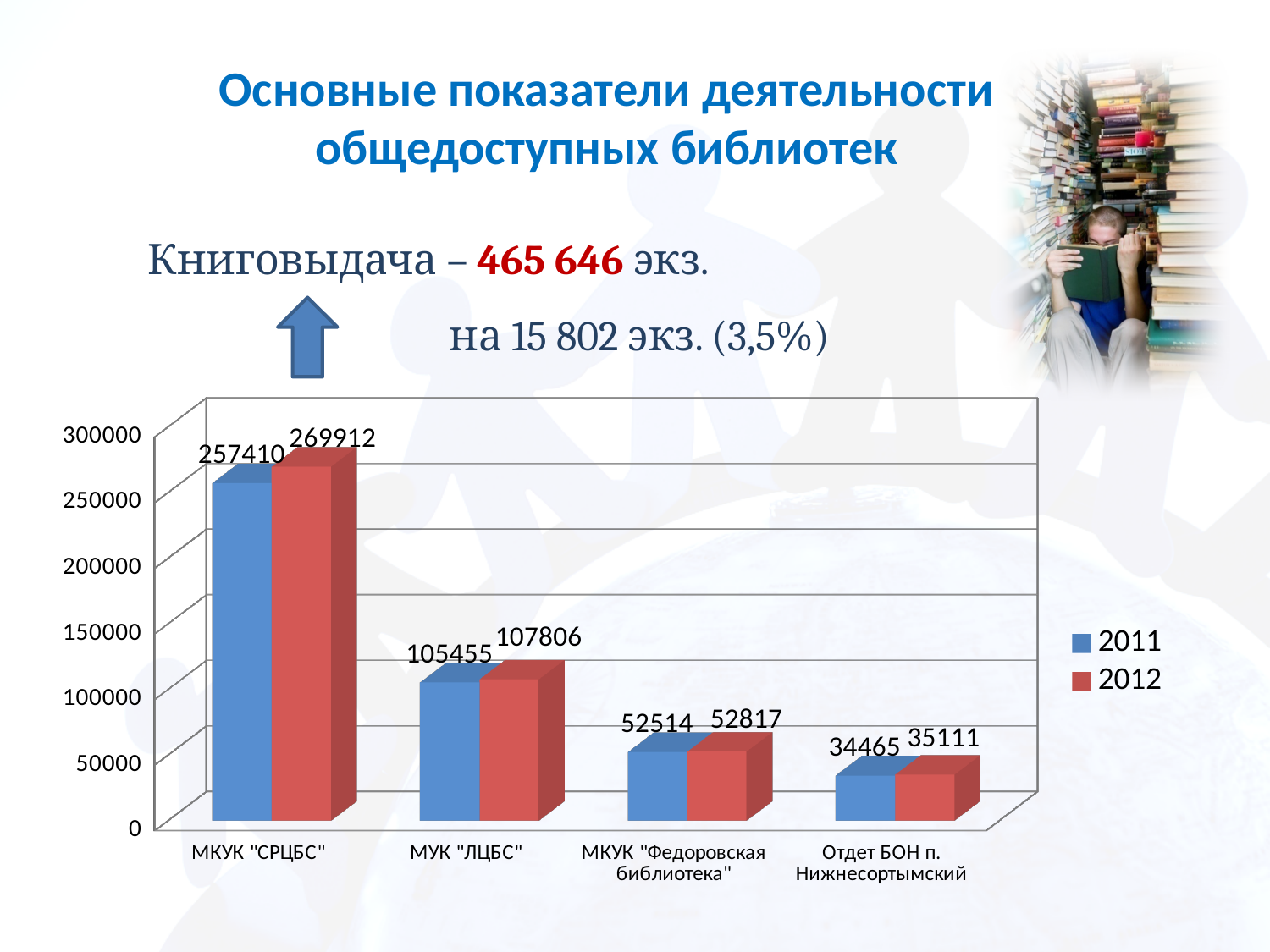
What is the difference between the 2012 and 2011 values for МКУК "СРЦБС"? 12502 How many series does the legend list? 2 What is the 2012 value for МКУК "СРЦБС"? 269912 Which colour represents the 2012 series in the legend? Red What kind of chart is shown on the slide? Bar chart What is the difference between the 2012 and 2011 values for МКУК "Федоровская библиотека"? 303 What is the 2012 value for Отдет БОН п. Нижнесортымский? 35111 Which category has the highest 2012 value? МКУК "СРЦБС" What is the 2011 value for МУК "ЛЦБС"? 105455 How many categories are shown on the x axis? 4 Which is larger: the 2011 value for МУК "ЛЦБС" or the 2012 value for МКУК "Федоровская библиотека"? 2011 value for МУК "ЛЦБС" Which category has the lowest 2011 value? Отдет БОН п. Нижнесортымский